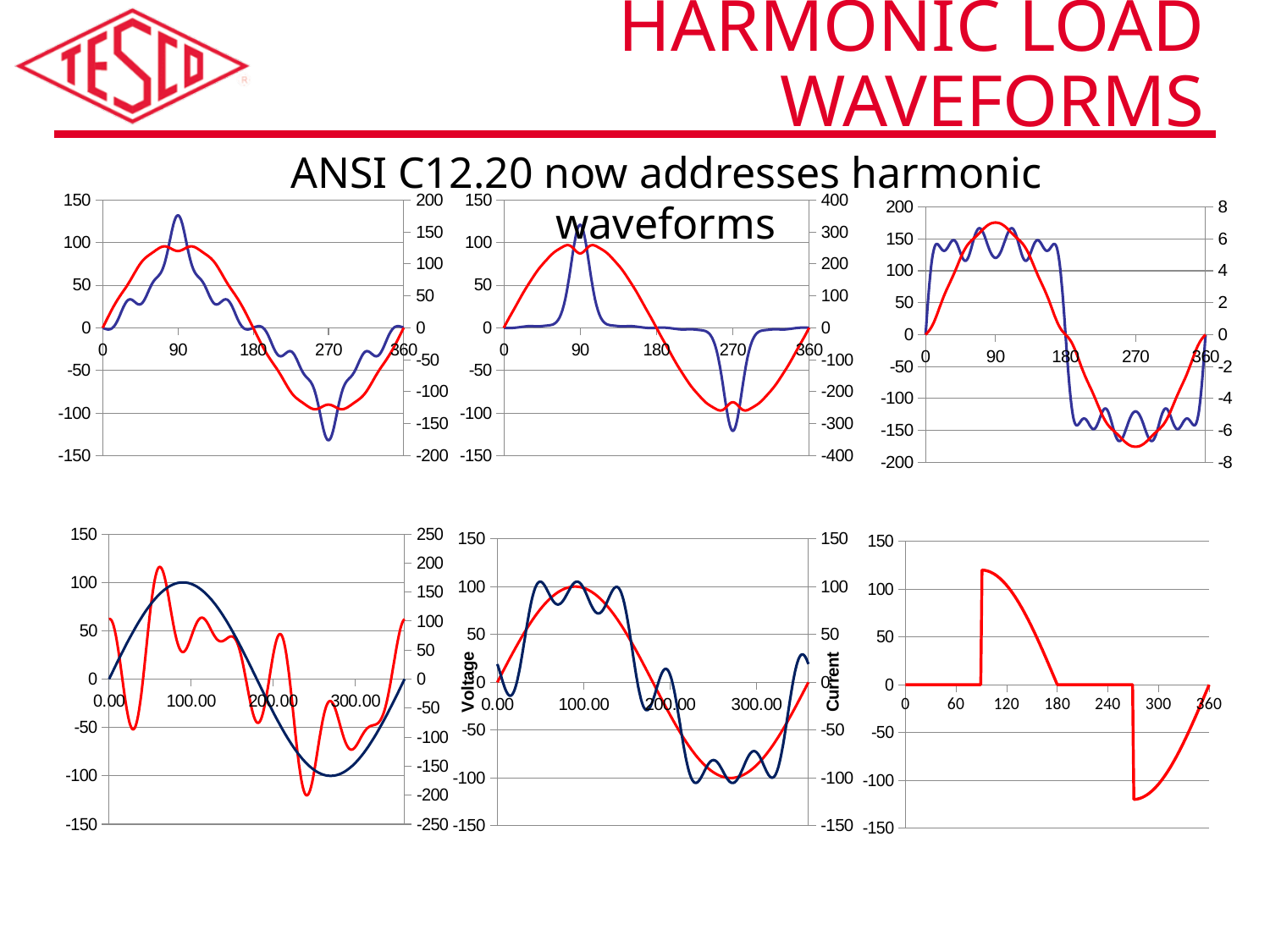
In the bottom-middle chart, what is the title of the left vertical axis? Voltage How many charts are shown on the slide? 6 In the bottom-right chart, does the line rise or fall between x = 270 and x = 360? rise In the top-right chart, is the value of the red line at x = 270 greater or less than -100? less In the bottom-right chart, does the line rise or fall between x = 90 and x = 180? fall What kind of chart is the bottom-right chart on the slide? Line chart What is the maximum value shown on the right-hand vertical axis of the top-right chart? 8 In the top-left chart, is the value of the red line at x = 90 greater or less than 50? greater In the bottom-right chart, is the value of the line at x = 120 greater or less than 50? greater In the bottom-right chart, what is the value of the line at x = 240? 0 How many tick labels are shown on the x axis of the bottom-right chart? 7 In the bottom-right chart, what is the value of the line at x = 60? 0